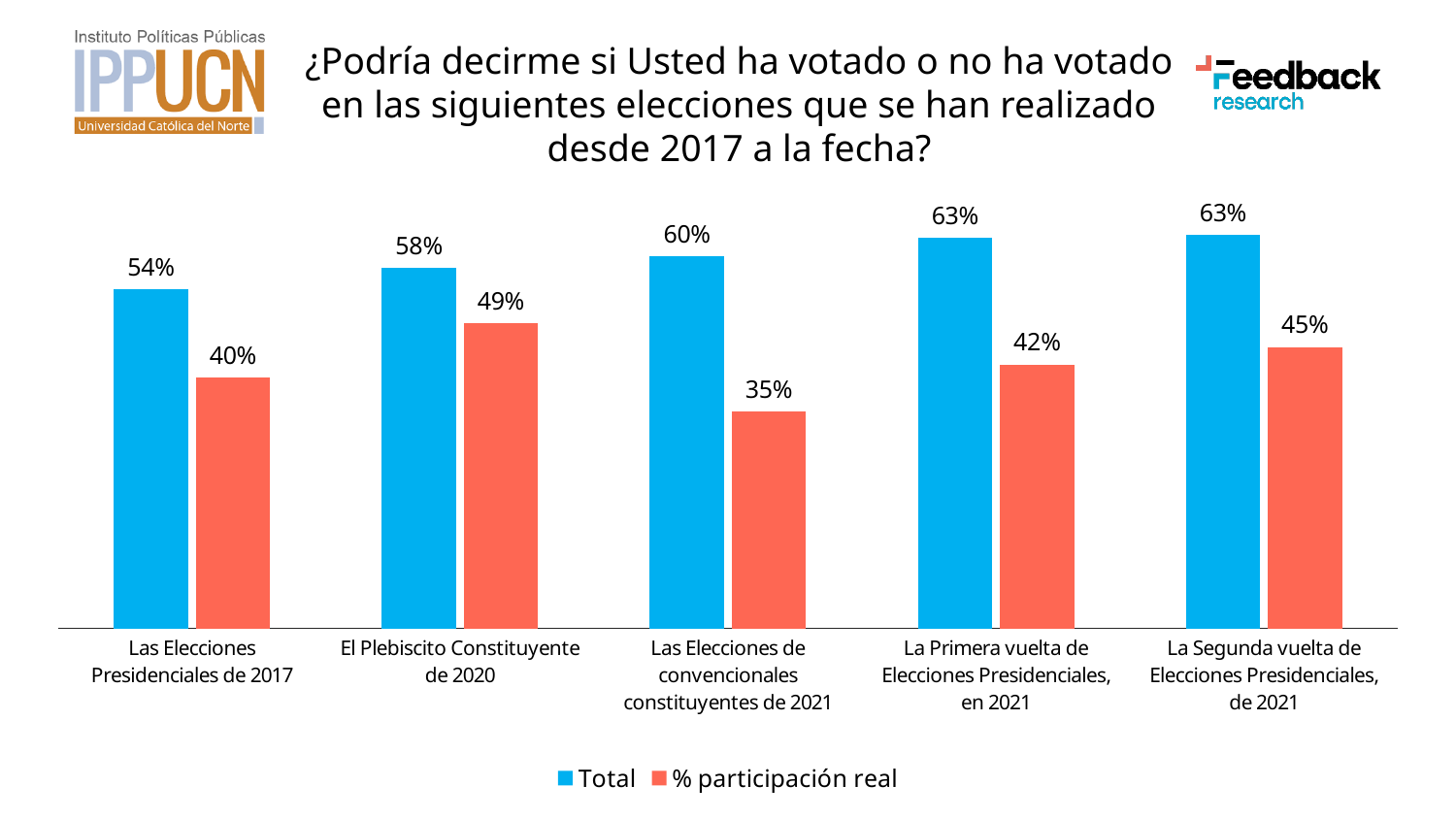
Which series is shown in blue according to the legend? Total Which category has the lowest Total value? Las Elecciones Presidenciales de 2017 What kind of chart is shown on the slide? Bar chart What is the % participación real value for Las Elecciones de convencionales constituyentes de 2021? 35% Which is larger: the % participación real value for La Segunda vuelta de Elecciones Presidenciales, de 2021 or for La Primera vuelta de Elecciones Presidenciales, en 2021? La Segunda vuelta de Elecciones Presidenciales, de 2021 What is the Total value for Las Elecciones Presidenciales de 2017? 54% What is the % participación real value for El Plebiscito Constituyente de 2020? 49% Which category has the lowest % participación real value? Las Elecciones de convencionales constituyentes de 2021 How many series does the legend list? 2 How many election categories are shown on the x axis? 5 What is the difference between the Total and % participación real values for Las Elecciones de convencionales constituyentes de 2021? 25% What is the Total value for La Primera vuelta de Elecciones Presidenciales, en 2021? 63%